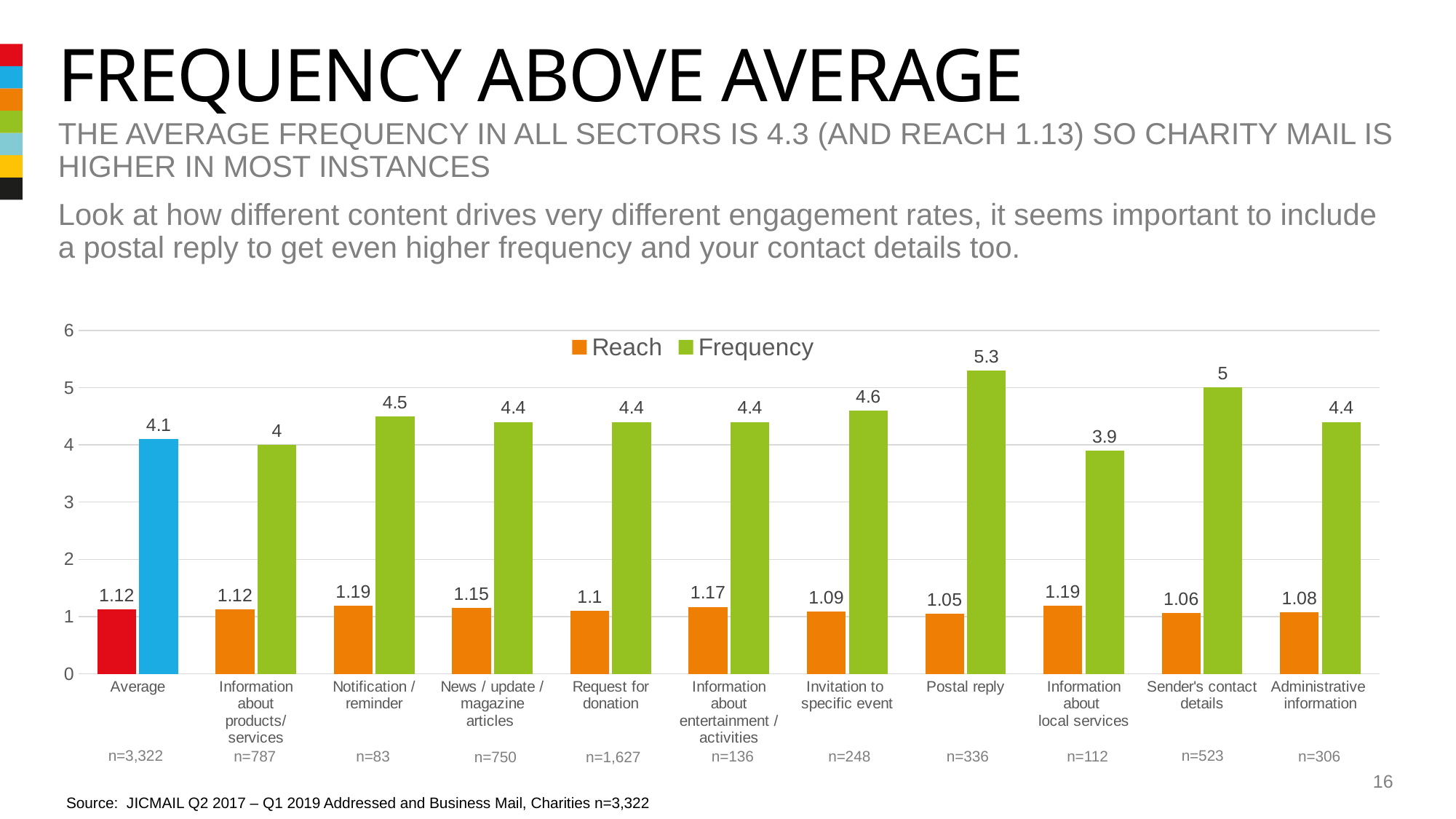
Which category has the lowest Reach value? Postal reply What is the Frequency value for Postal reply? 5.3 What is the Reach value for Average? 1.12 What kind of chart is shown on the slide? Bar chart Which category has the lowest Frequency value? Information about local services Which category has the highest Frequency value? Postal reply How many categories are shown on the x axis? 11 What is the difference between the Frequency value for Postal reply and the Frequency value for Average? 1.2 How many series does the legend list? 2 Which is larger: the Frequency value for Sender's contact details or the Frequency value for Information about products/services? Sender's contact details What is the Reach value for Notification / reminder? 1.19 What is the Frequency value for Information about local services? 3.9